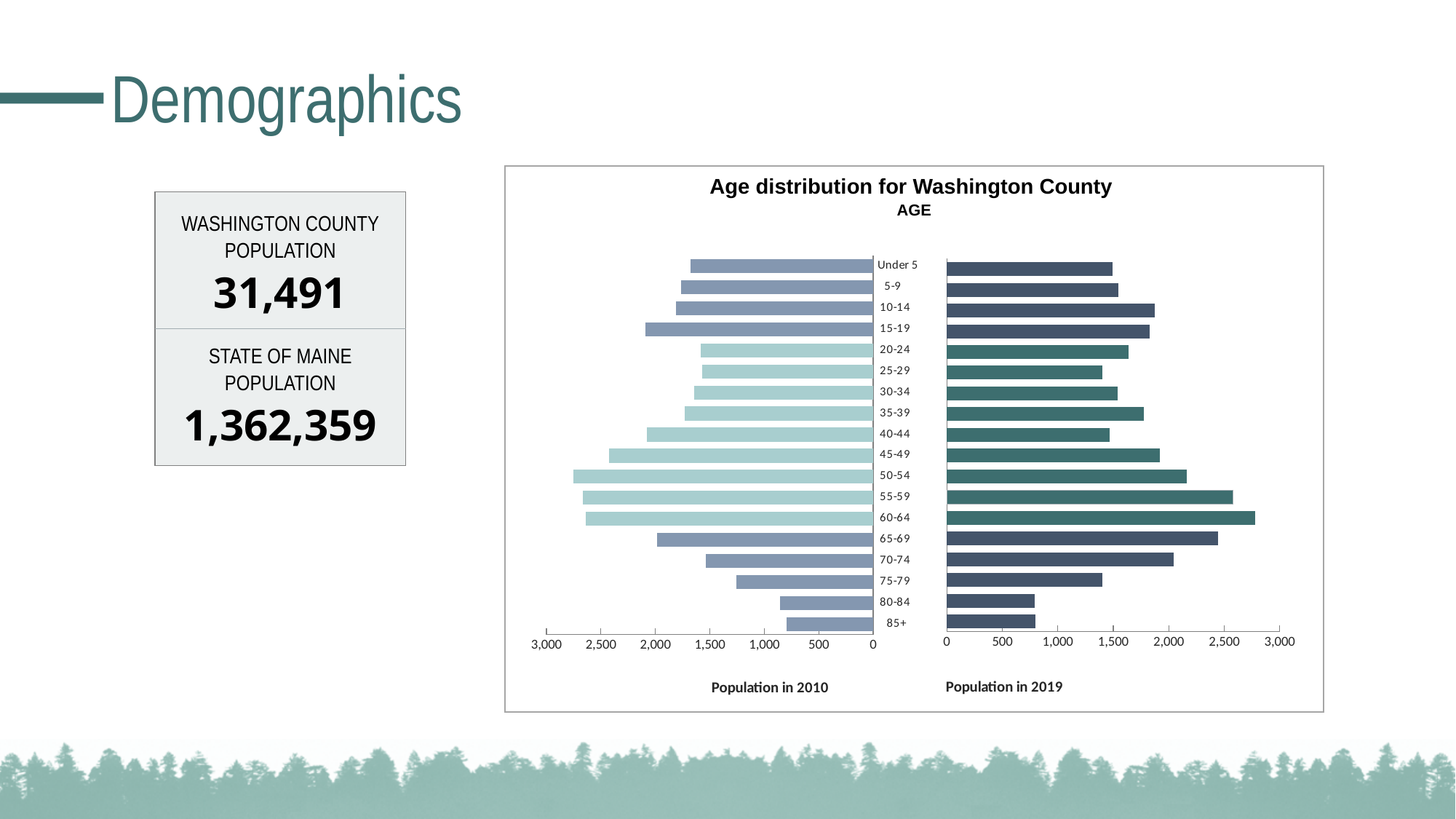
Is the value for the 50-54 age group in the Population in 2010 series greater or less than 2,500? greater What is the title of the chart? Age distribution for Washington County Is the value for the 45-49 age group in the Population in 2010 series greater or less than 2,000? greater Which series is plotted on the left side of the chart? Population in 2010 Is the value for the 80-84 age group in the Population in 2019 series greater or less than 1,000? less What kind of chart is shown on the slide? Bar chart How many age groups are shown in the chart? 18 Which age group has the highest value in the Population in 2019 series? 60-64 How many population series does the chart show? 2 For the 50-54 age group, which series has the larger value, Population in 2010 or Population in 2019? Population in 2010